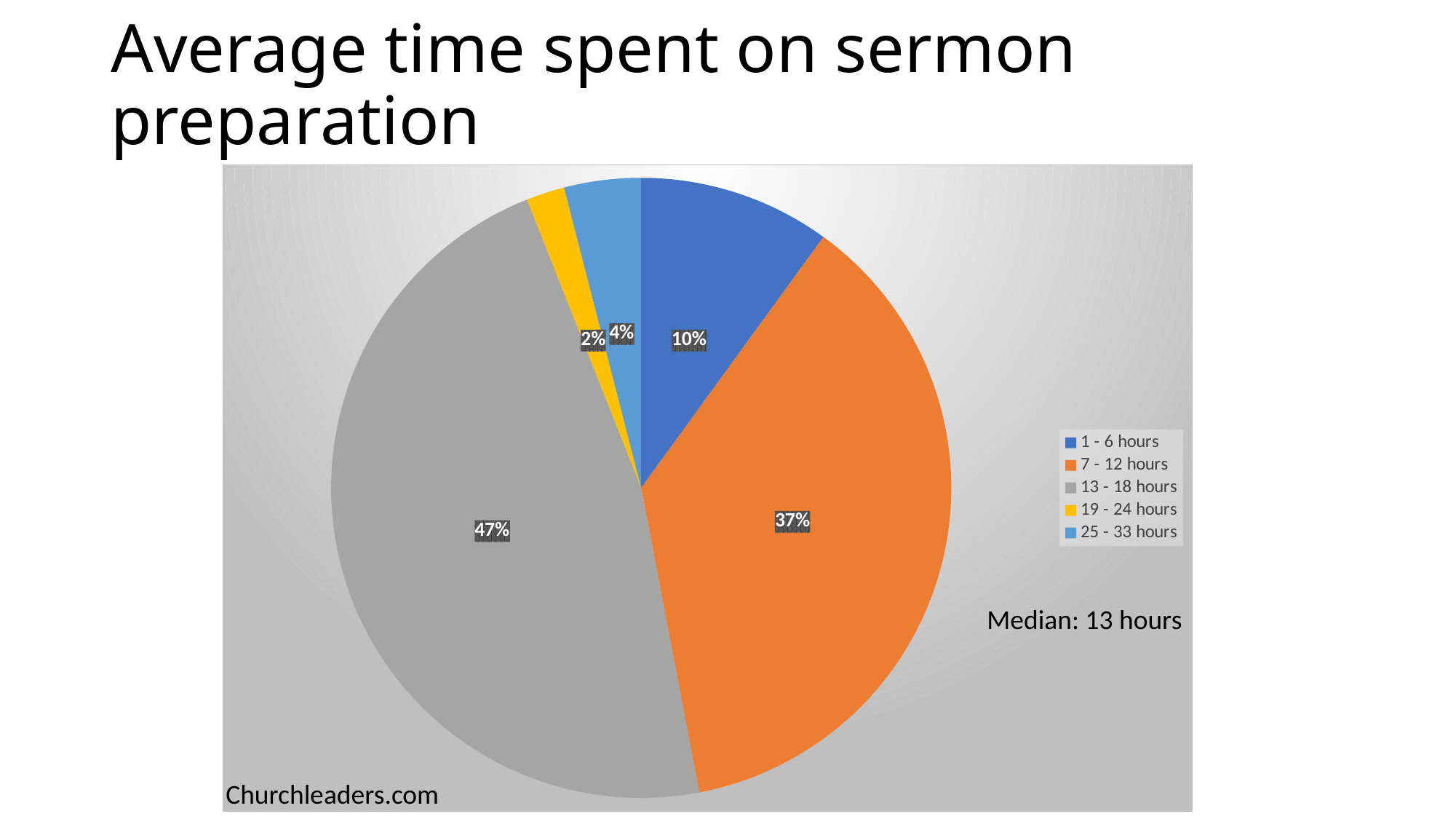
What share of the pie does the 13 - 18 hours slice represent? 47% What median value is stated on the slide? 13 hours Which slice is larger, 1 - 6 hours or 25 - 33 hours? 1 - 6 hours What kind of chart is shown on the slide? pie chart What is the difference in percentage points between the 13 - 18 hours slice and the 7 - 12 hours slice? 10 What is the value shown for the 25 - 33 hours slice? 4% What is the value shown for the 1 - 6 hours slice? 10% Which category has the smallest slice of the pie? 19 - 24 hours What is the value shown for the 7 - 12 hours slice? 37% Which category has the largest slice of the pie? 13 - 18 hours What is the value shown for the 19 - 24 hours slice? 2% How many categories does the legend list? 5